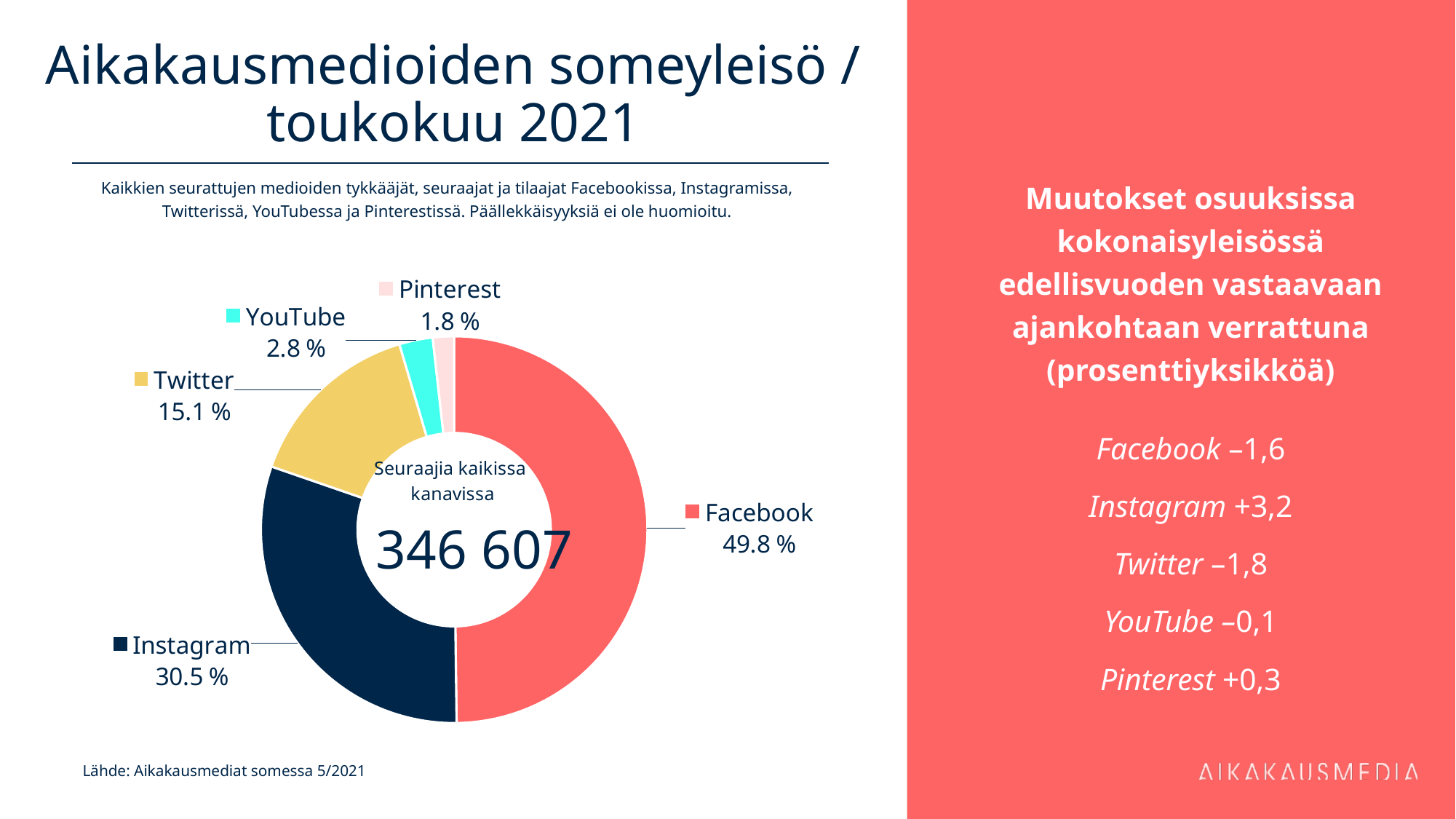
How many percentage points larger is Facebook's share than Instagram's share? 19.3 Which has a larger share in the donut chart, Twitter or YouTube? Twitter What share of the audience does Instagram hold in the donut chart? 30.5 % What type of chart is used on the slide? Donut (pie) chart What percentage is shown for Pinterest in the donut chart? 1.8 % What percentage is shown for Twitter in the donut chart? 15.1 % Which platform has the smallest share in the donut chart? Pinterest How many platforms (slices) are shown in the donut chart? 5 What share of the social media audience does Facebook hold according to the donut chart? 49.8 % What percentage is shown for YouTube in the donut chart? 2.8 % What total number of followers across all channels is shown in the centre of the donut chart? 346 607 Which platform has the largest share in the donut chart? Facebook